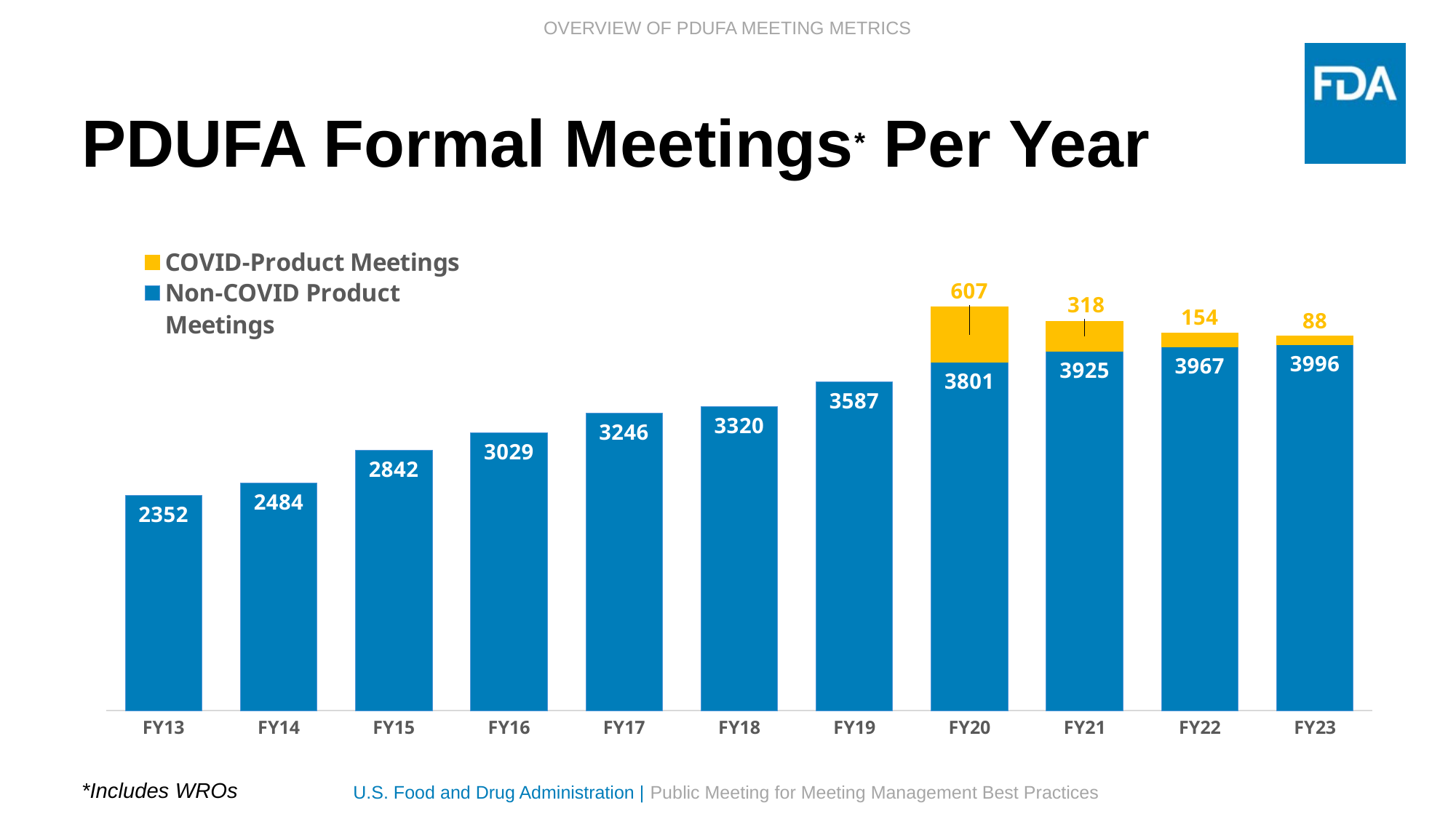
How many series does the legend list? 2 Do the Non-COVID Product Meetings rise or fall from FY13 to FY23? Rise What is the number of COVID-Product Meetings in FY20? 607 What kind of chart is shown on the slide? Stacked bar chart What is the difference between Non-COVID Product Meetings in FY19 and FY18? 267 Which fiscal year has the lowest number of Non-COVID Product Meetings? FY13 Which fiscal year has the highest number of COVID-Product Meetings? FY20 What is the total number of meetings in FY20 (COVID and Non-COVID combined)? 4408 What is the number of Non-COVID Product Meetings in FY13? 2352 How many fiscal years are shown on the x axis? 11 What is the number of Non-COVID Product Meetings in FY23? 3996 Which is larger: COVID-Product Meetings in FY21 or in FY22? FY21